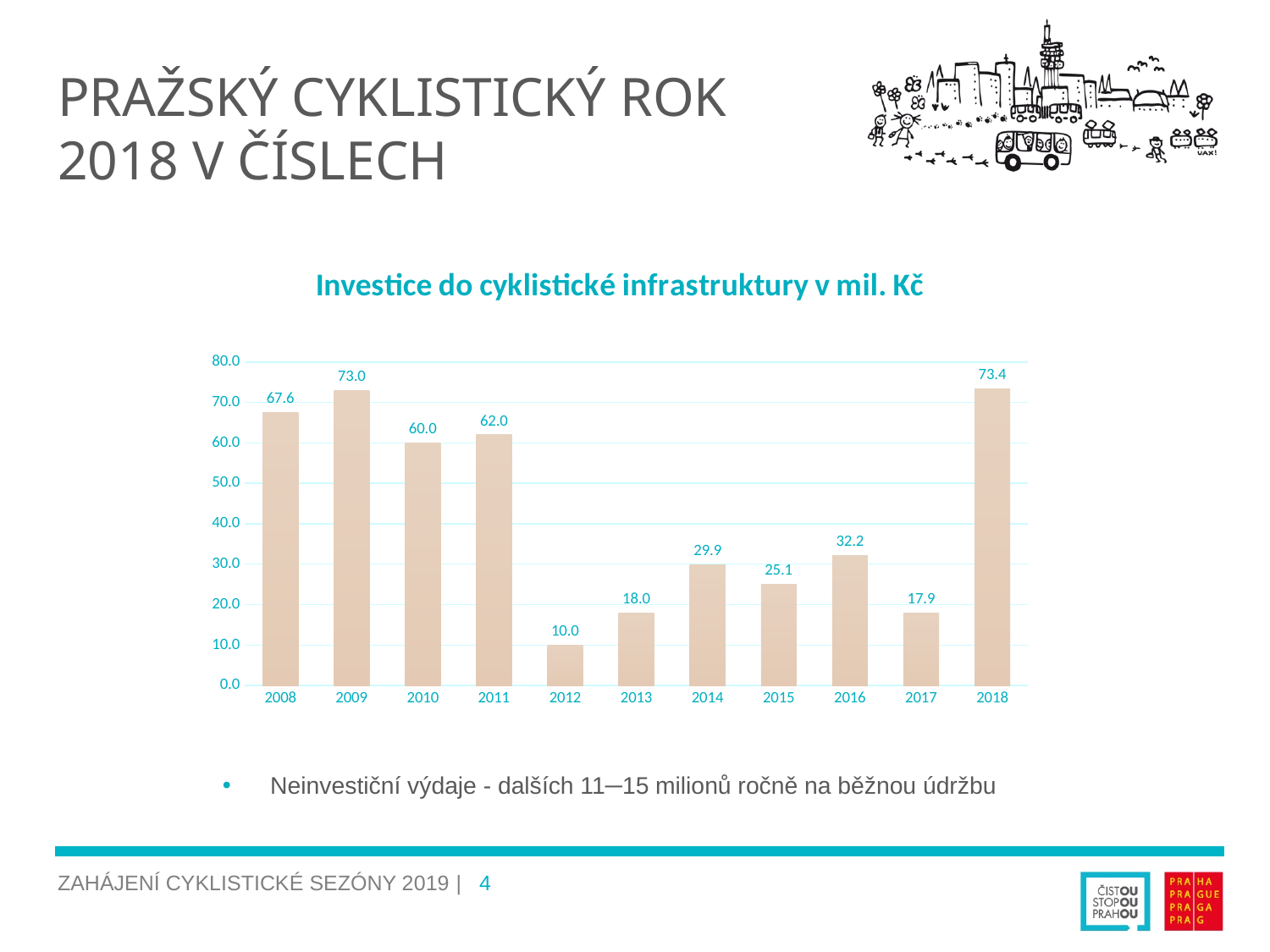
What kind of chart is this? bar chart Do the values rise or fall from 2011 to 2012? fall What is the title of the chart? Investice do cyklistické infrastruktury v mil. Kč How many years are shown on the x axis? 11 What is the difference between the values for 2016 and 2017? 14.3 Which year has the highest value? 2018 Which year has the lowest value? 2012 What is the value for 2012? 10.0 Which is larger, the value for 2010 or the value for 2011? 2011 What is the value for 2018? 73.4 What is the difference between the values for 2009 and 2008? 5.4 What is the value for 2015? 25.1